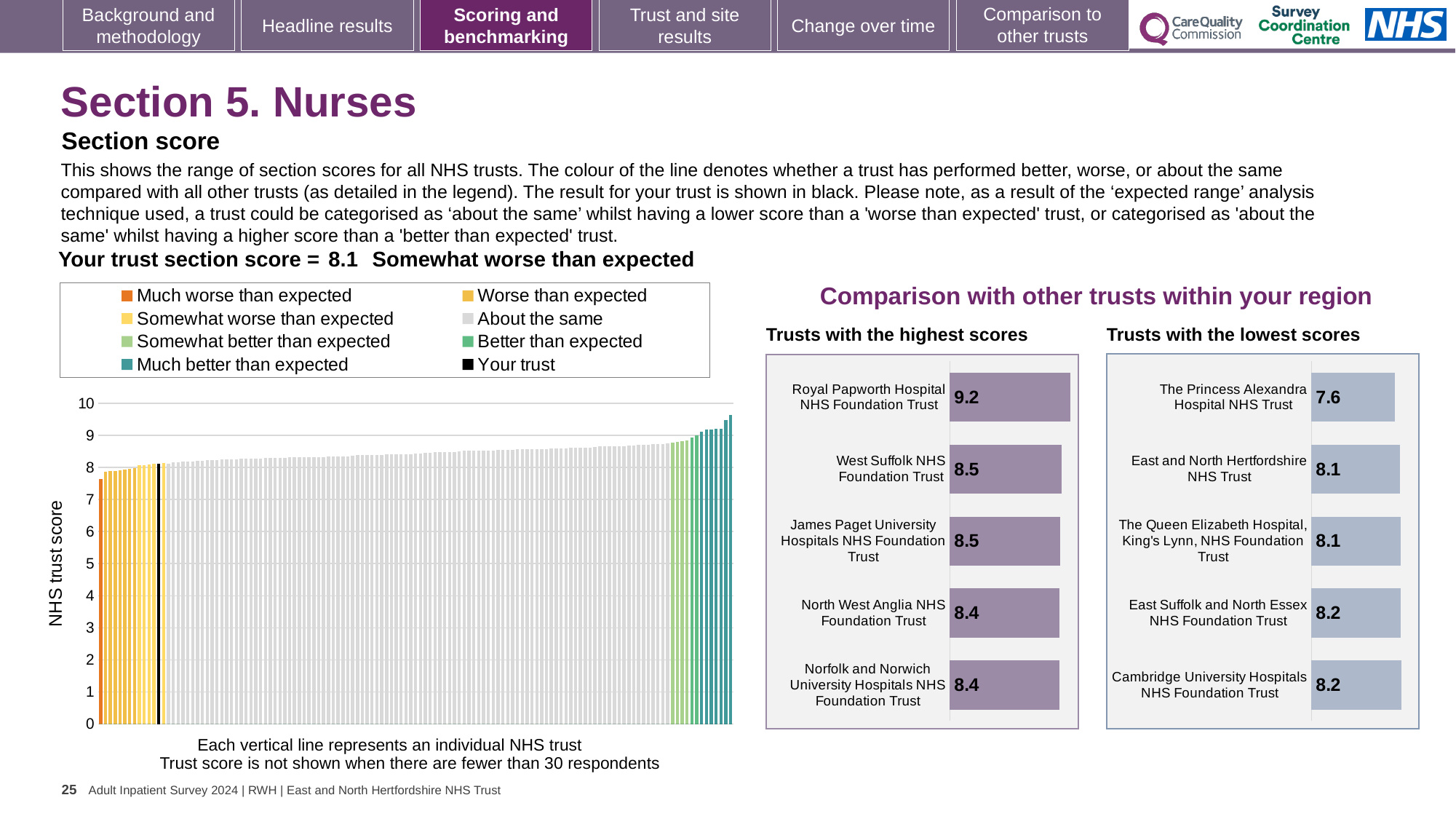
In the 'Trusts with the lowest scores' chart, what is the difference between the scores of Cambridge University Hospitals NHS Foundation Trust and The Princess Alexandra Hospital NHS Trust? 0.6 In the 'Trusts with the lowest scores' chart, which has the larger score: East Suffolk and North Essex NHS Foundation Trust or The Princess Alexandra Hospital NHS Trust? East Suffolk and North Essex NHS Foundation Trust How many trusts are shown in the 'Trusts with the highest scores' chart? 5 What kind of chart is the large 'NHS trust score' chart on the left of the slide? Bar chart In the 'Trusts with the lowest scores' chart, which trust has the lowest score? The Princess Alexandra Hospital NHS Trust In the 'NHS trust score' chart on the left, do the trust scores rise or fall from left to right? Rise In the 'Trusts with the highest scores' chart, which trust has the highest score? Royal Papworth Hospital NHS Foundation Trust In the 'Trusts with the highest scores' chart, what is the score for Royal Papworth Hospital NHS Foundation Trust? 9.2 In the 'Trusts with the highest scores' chart, what is the difference between the scores of Royal Papworth Hospital NHS Foundation Trust and West Suffolk NHS Foundation Trust? 0.7 In the 'Trusts with the lowest scores' chart, what is the score for The Princess Alexandra Hospital NHS Trust? 7.6 How many entries does the legend of the 'NHS trust score' chart on the left list? 8 In the 'Trusts with the lowest scores' chart, what is the score for Cambridge University Hospitals NHS Foundation Trust? 8.2